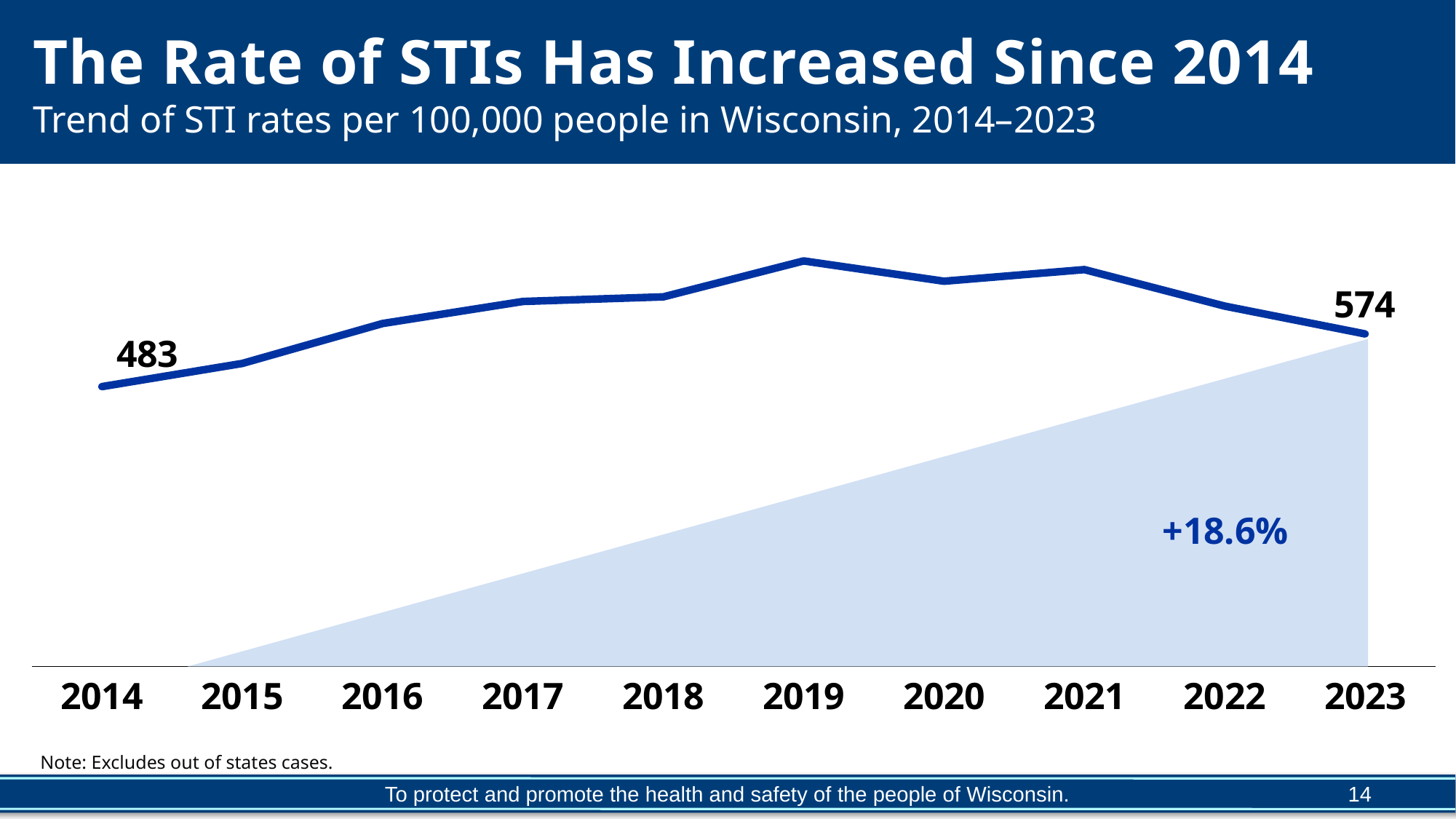
What is the STI rate per 100,000 people in Wisconsin for 2014? 483 Does the STI rate rise or fall from 2014 to 2019? Rise What is the title of the slide? The Rate of STIs Has Increased Since 2014 Which year has a higher STI rate, 2019 or 2022? 2019 Which year has the highest STI rate on the chart? 2019 What percentage change is annotated on the chart between 2014 and 2023? +18.6% What kind of chart is shown on the slide? Line chart What is the STI rate per 100,000 people in Wisconsin for 2023? 574 Which year has the lowest STI rate on the chart? 2014 What is the difference between the STI rate in 2023 and the STI rate in 2014? 91 Which year has a higher STI rate, 2014 or 2023? 2023 How many years are plotted on the chart? 10